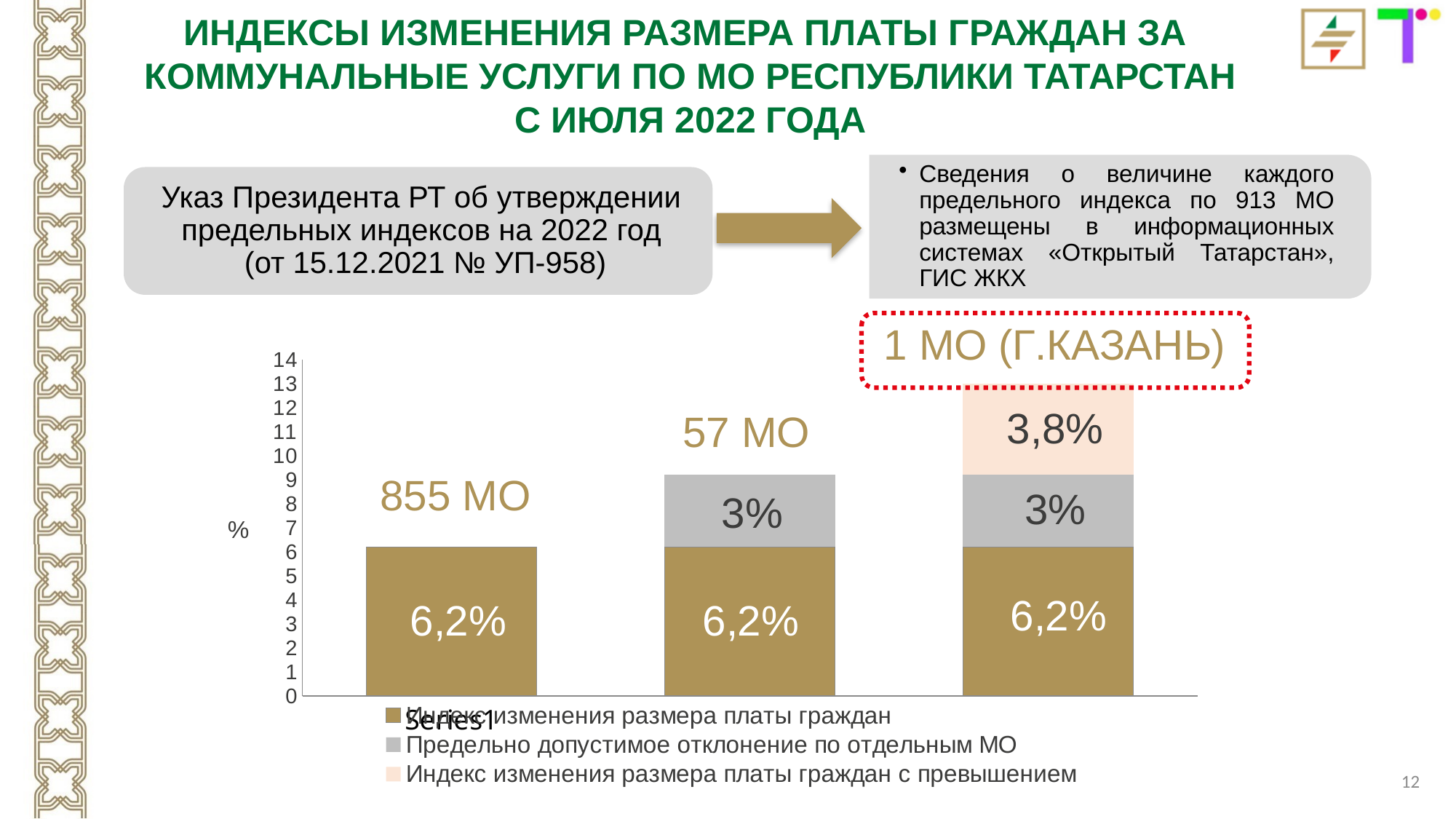
What label is shown on the vertical axis of the chart? % What is the difference between the total of the 1 МО (Г.КАЗАНЬ) bar and the total of the 57 МО bar? 3,8% What is the value of the top (light pink) segment for the bar labelled 1 МО (Г.КАЗАНЬ)? 3,8% How many bars (categories) does the chart show? 3 Which bar has the lowest total value? 855 МО What is the total of the stacked bar labelled 57 МО? 9,2% Is the total of the bar labelled 855 МО greater or less than 7? less What kind of chart is shown on the slide? bar chart What is the value of the grey segment for the bar labelled 57 МО? 3% Which bar has the highest total value? 1 МО (Г.КАЗАНЬ) What is the value of the bottom (dark gold) segment for the bar labelled 855 МО? 6,2% What is the total of the stacked bar labelled 1 МО (Г.КАЗАНЬ)? 13%